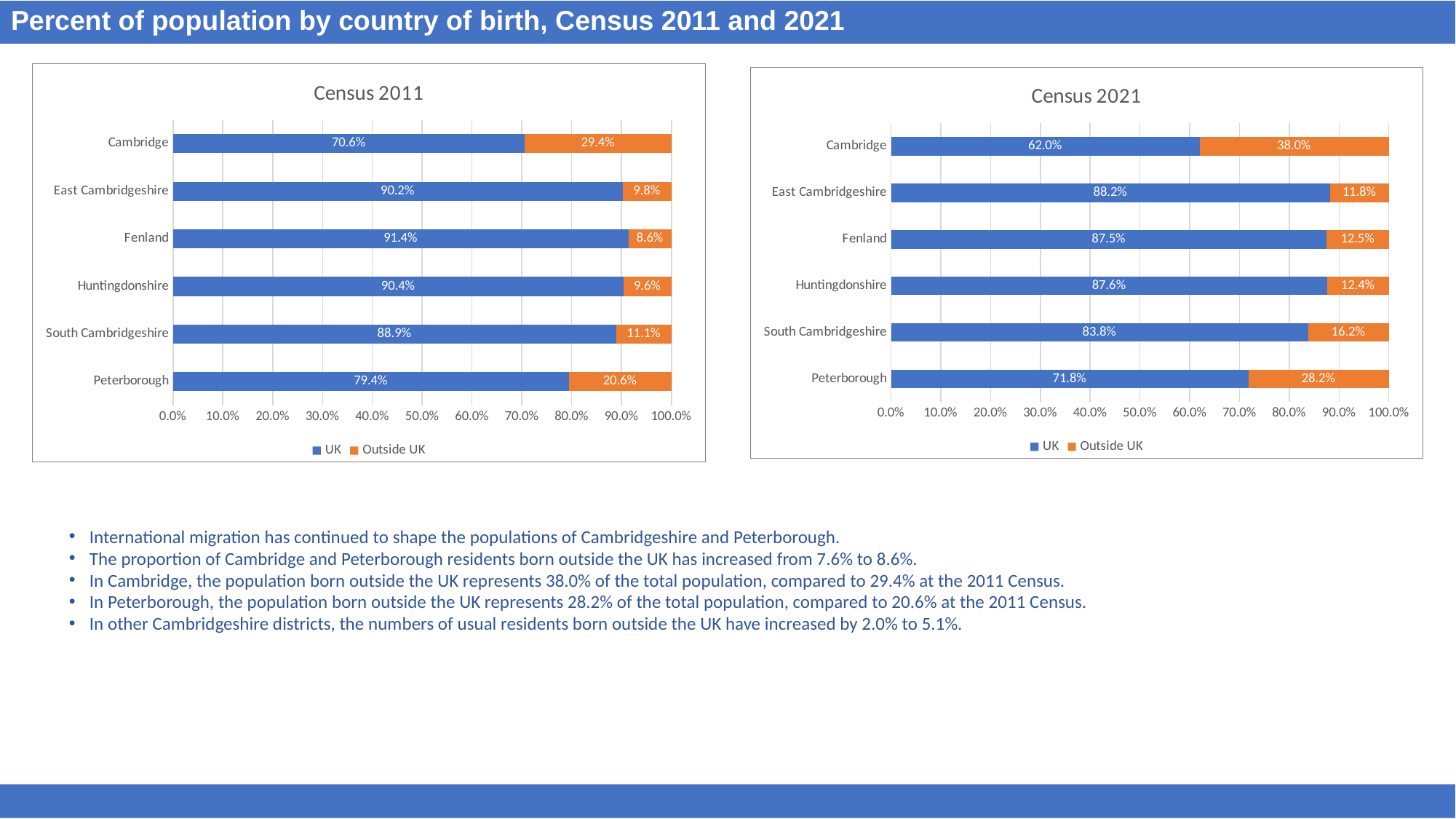
What colour represents the Outside UK series in the Census 2011 chart? Orange How many series does the legend of the Census 2021 chart list? 2 In the Census 2021 chart, what is the difference between the Outside UK values for Cambridge and Peterborough? 9.8% In the Census 2011 chart, which district has the highest UK value? Fenland In the Census 2021 chart, is the UK value for Cambridge greater or less than 70.0%? less In the Census 2011 chart, which is larger: the Outside UK value for South Cambridgeshire or for Huntingdonshire? South Cambridgeshire In the Census 2021 chart, which district has the lowest UK value? Cambridge What kind of chart is the Census 2011 chart? Stacked bar chart How many districts are shown in the Census 2011 chart? 6 In the Census 2011 chart, what is the UK value for Cambridge? 70.6% In the Census 2021 chart, what is the total of the stacked bar for Fenland? 100.0% In the Census 2021 chart, what is the Outside UK value for Peterborough? 28.2%